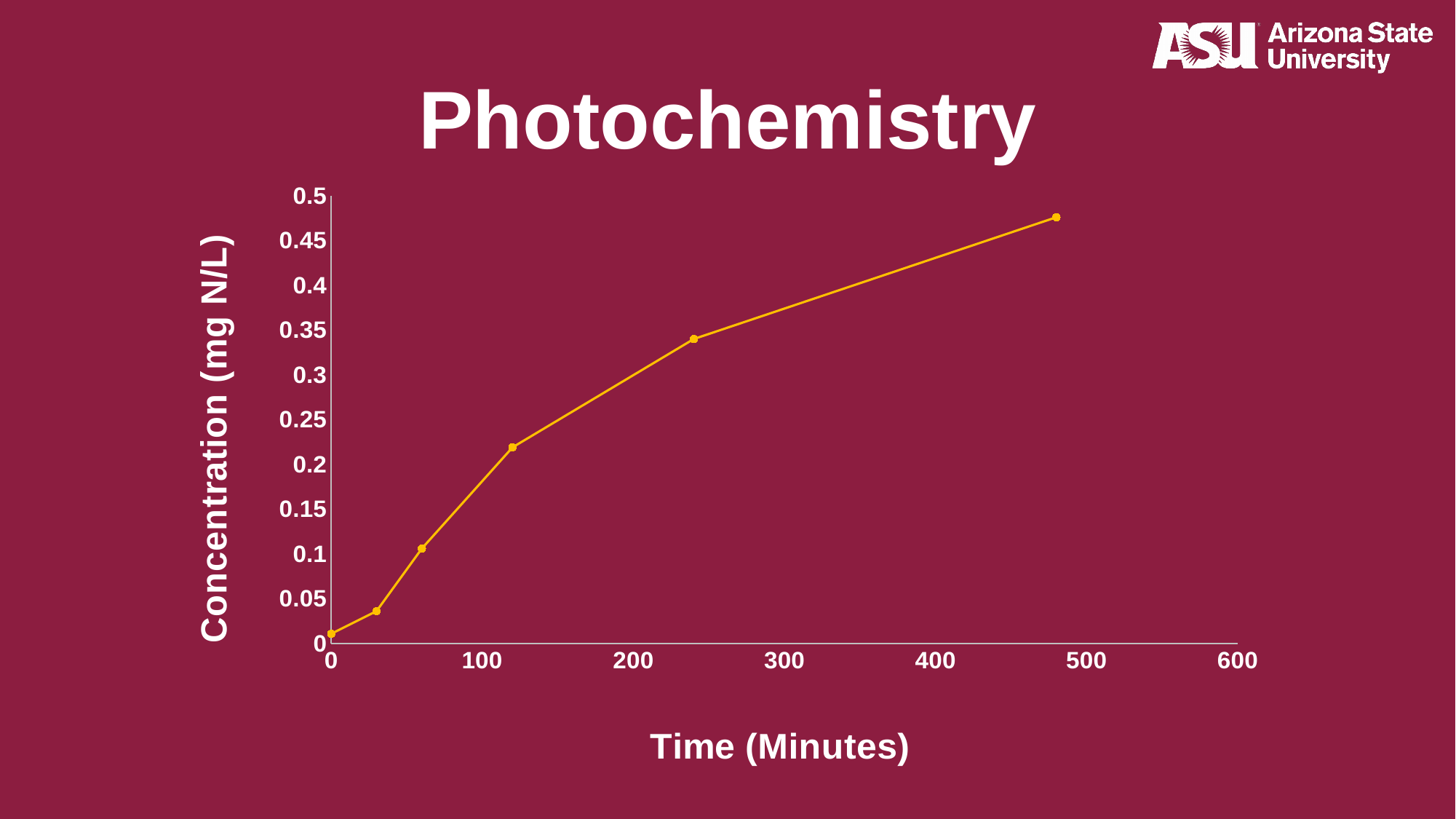
What is the label of the y axis? Concentration (mg N/L) How many data points are plotted on the line? 6 Is the concentration at the data point between 200 and 300 minutes greater or less than 0.3? greater What is the maximum value shown on the x axis? 600 What kind of chart is shown on the slide? line chart Does the concentration rise or fall as time increases along the x axis? rise Is the concentration at the last (rightmost) data point greater or less than 0.45? greater What is the title of the slide containing the chart? Photochemistry Is the concentration at the first data point (time 0) greater or less than 0.05? less Which data point has the highest concentration, the first or the last? the last